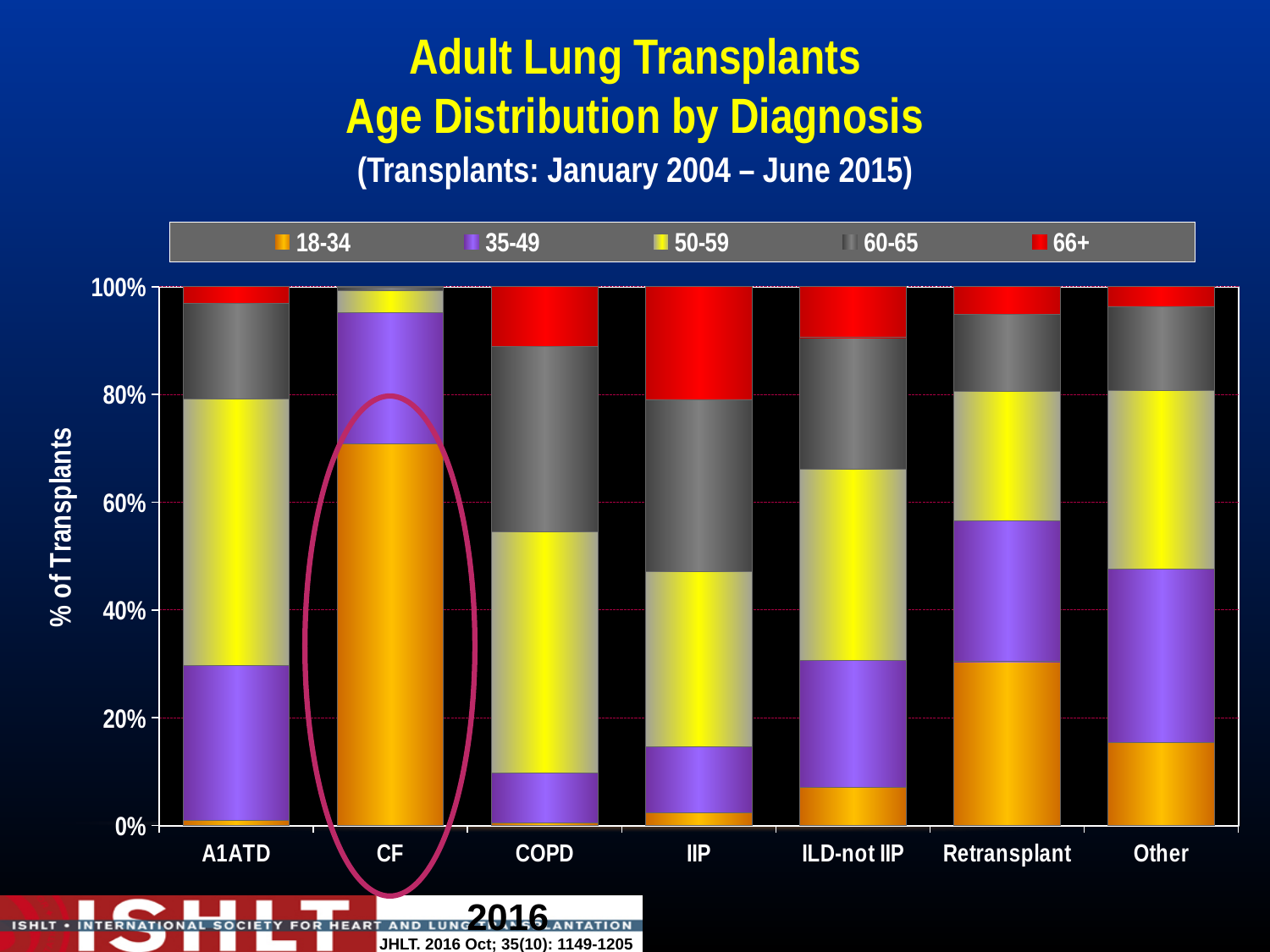
How many diagnosis categories are shown on the x axis? 7 Which diagnosis category is circled on the chart? CF What does each stacked bar total on the y axis? 100% What kind of chart is shown on the slide? Stacked bar chart Is the 18-34 share for COPD greater or less than 20%? less Which diagnosis has the largest share of transplants in the 18-34 age group? CF Is the 18-34 share for CF greater or less than 60%? greater Is the 18-34 share for Retransplant greater or less than 20%? greater Which diagnosis has the smallest share of transplants in the 66+ age group? CF Which has the larger 35-49 share, Other or COPD? Other Which diagnosis has the largest share of transplants in the 66+ age group? IIP How many age-group series does the legend list? 5